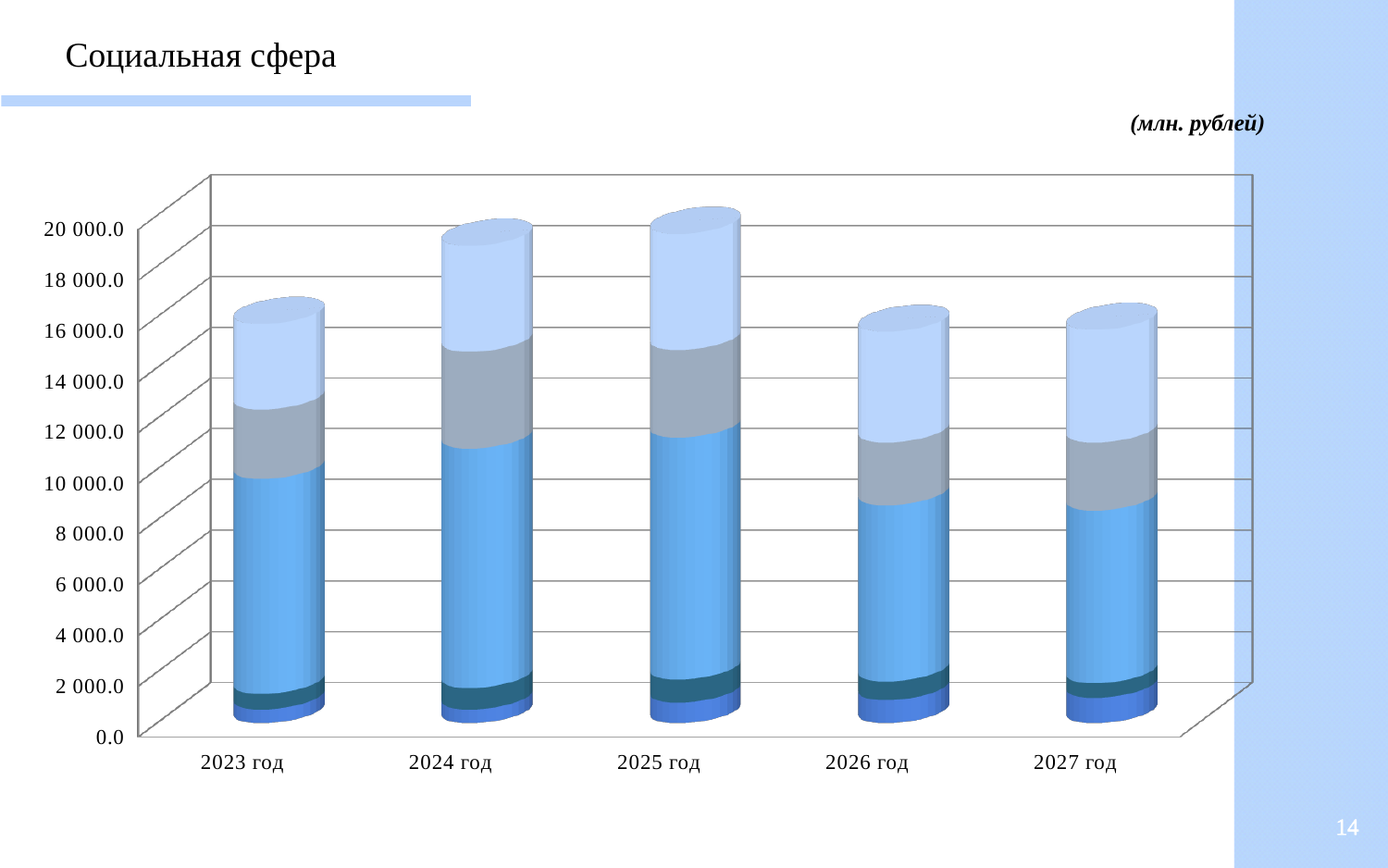
In what units are the values on the chart given? млн. рублей What kind of chart is shown on the slide? bar chart Is the total value for 2026 год greater or less than 18 000.0? less Is the total value for 2023 год greater or less than 18 000.0? less Is the total value for 2027 год greater or less than 14 000.0? greater Which has the larger total value, 2025 год or 2026 год? 2025 год How many years are shown on the x axis of the chart? 5 What is the title of the slide's chart? Социальная сфера Which has the larger total value, 2024 год or 2027 год? 2024 год Does the total value rise or fall from 2025 год to 2026 год? fall